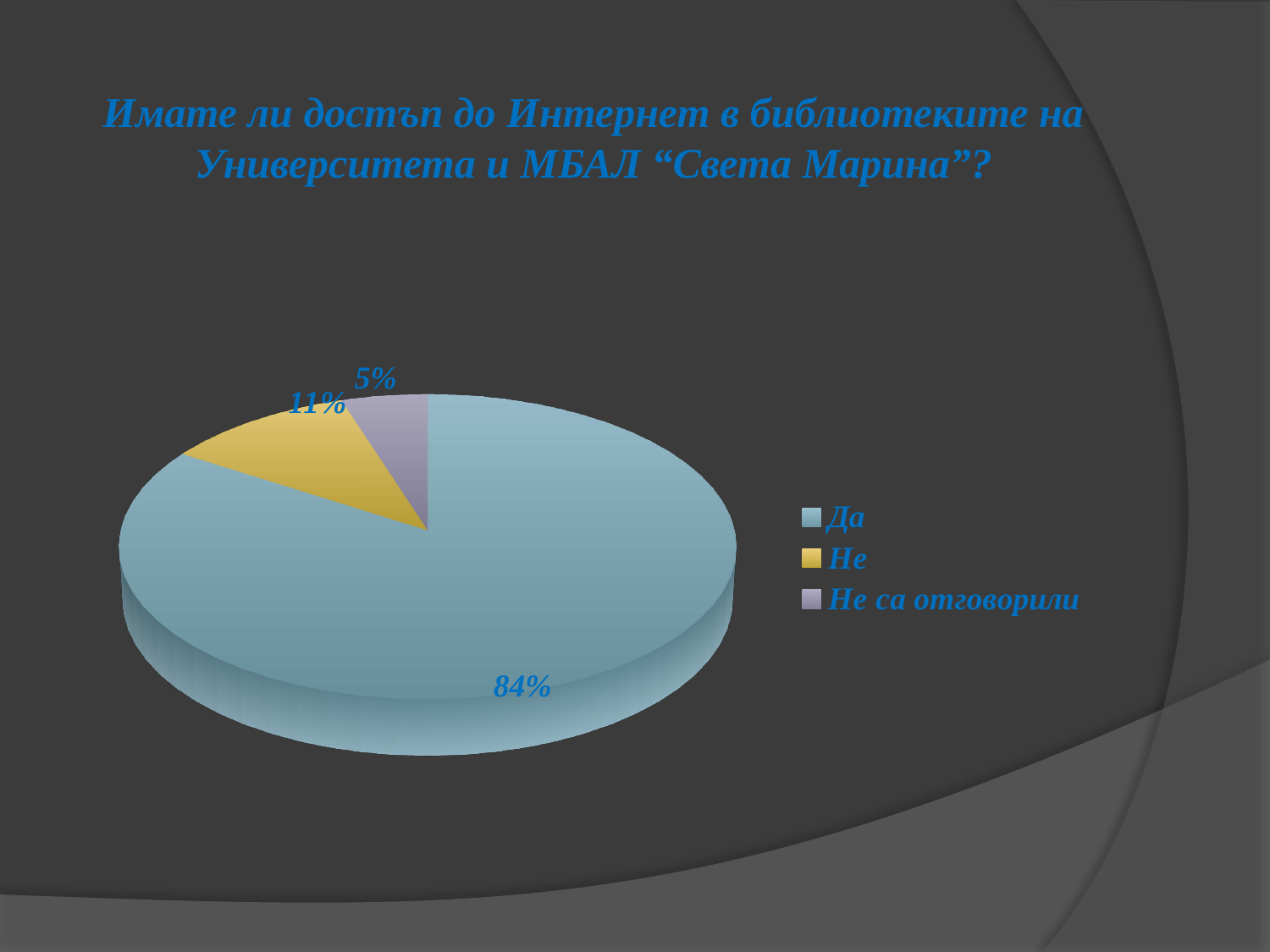
What kind of chart is shown on the slide? pie chart Which category has the largest share of the pie? Да What is the title of the chart? Имате ли достъп до Интернет в библиотеките на Университета и МБАЛ "Света Марина"? What is the difference in percentage points between "Да" and "Не"? 73 What percentage of respondents answered "Да"? 84% What percentage is shown for "Не са отговорили"? 5% What percentage of respondents answered "Не"? 11% What is the difference in percentage points between "Не" and "Не са отговорили"? 6 Which is larger, the share for "Не" or the share for "Не са отговорили"? Не Which category has the smallest share of the pie? Не са отговорили How many categories does the legend list? 3 What colour is the slice for "Не"? yellow